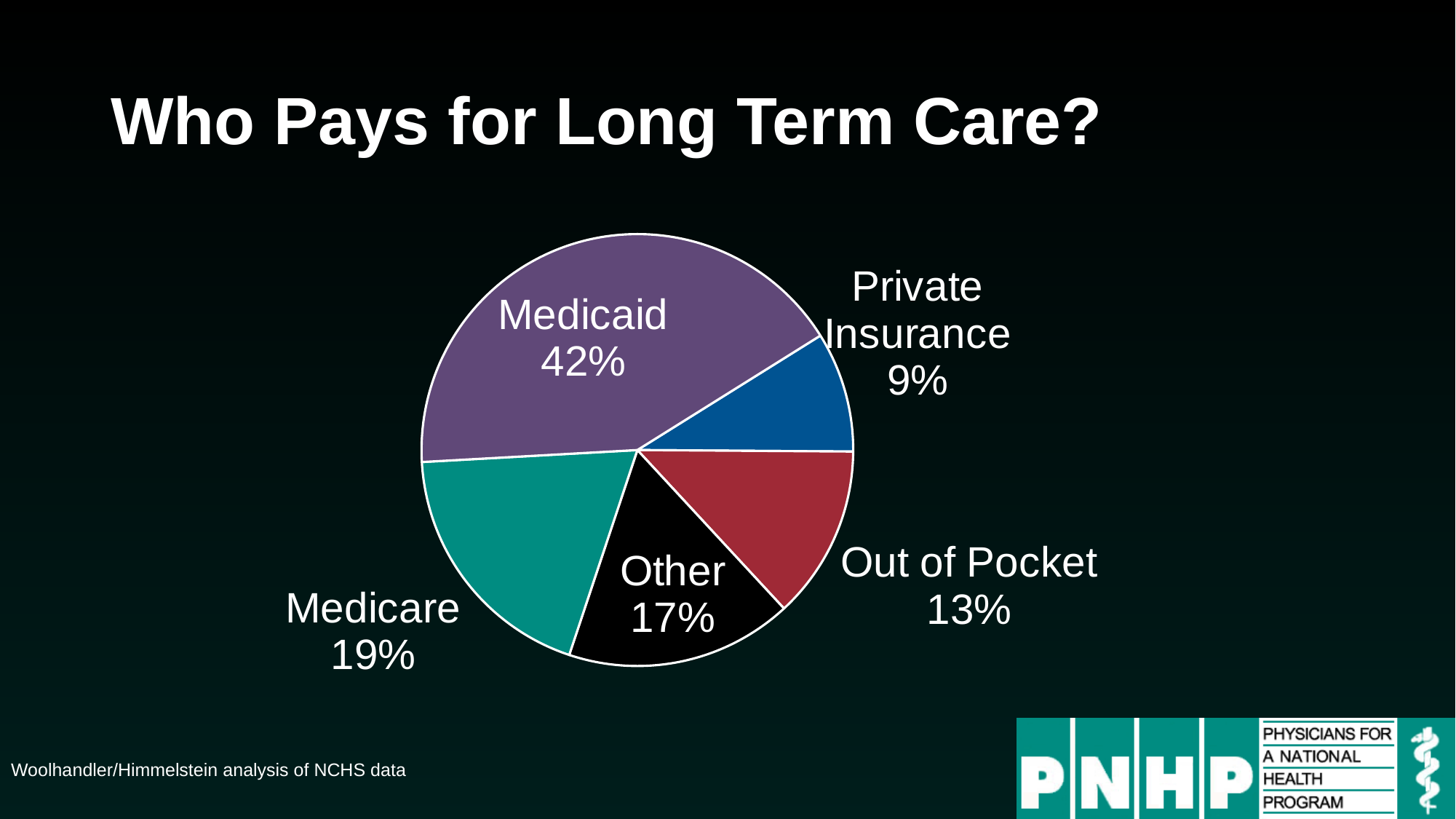
What share of long term care is paid by Medicaid? 42% What is the title of the chart on the slide? Who Pays for Long Term Care? What share of long term care is paid out of pocket? 13% Which payer has the largest slice of the pie? Medicaid How many slices does the pie chart have? 5 What share of long term care is paid by 'Other' sources? 17% What share of long term care is paid by Medicare? 19% What kind of chart is shown on the slide? Pie chart Which payer has the smallest slice of the pie? Private Insurance How many percentage points larger is Medicaid's share than Medicare's share? 23 What share of long term care is paid by private insurance? 9% Which is larger, the Out of Pocket share or the Private Insurance share? Out of Pocket